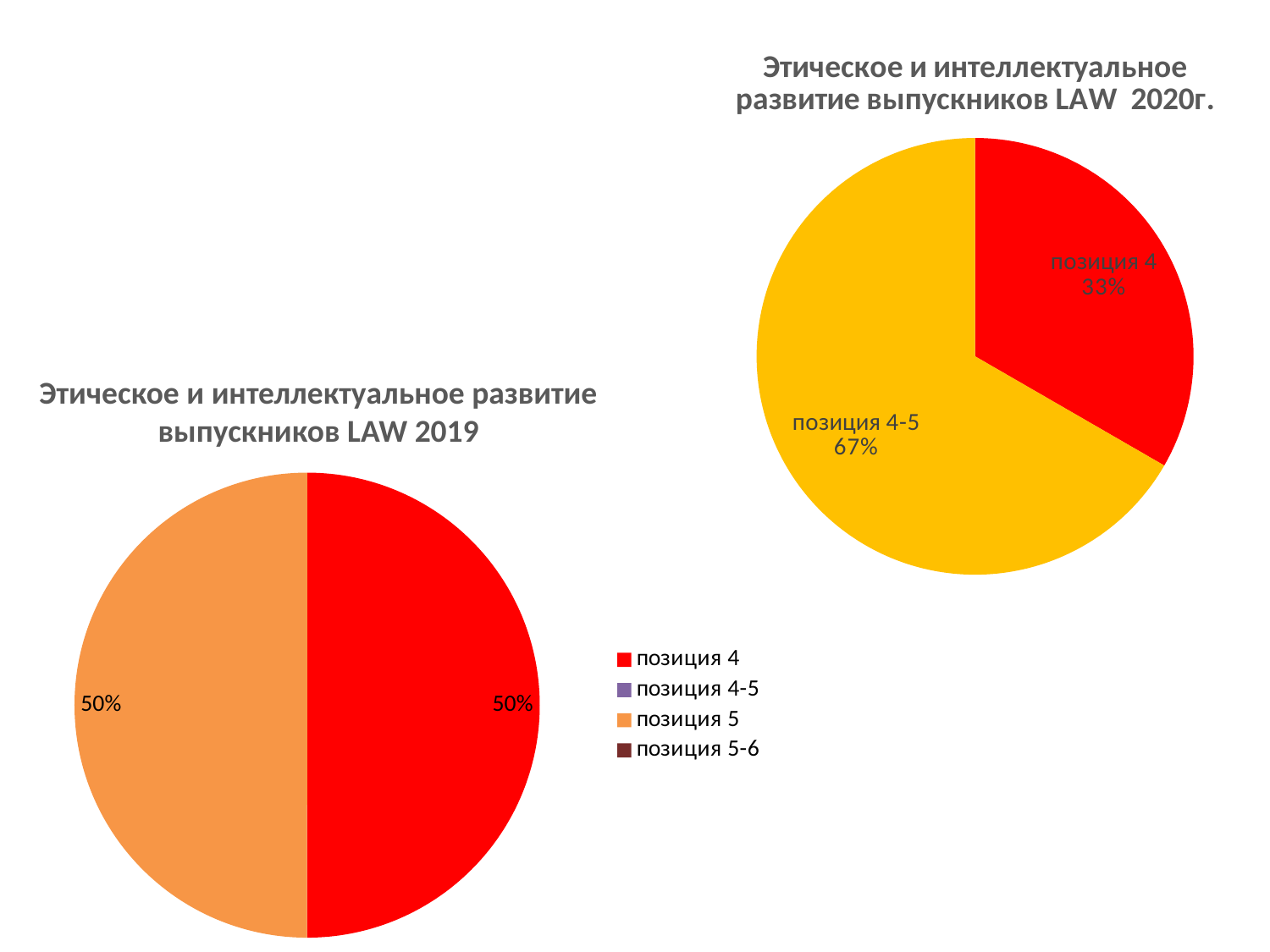
In the chart titled "Этическое и интеллектуальное развитие выпускников LAW 2020г.", how many slices does the pie have? 2 What kind of chart is the chart titled "Этическое и интеллектуальное развитие выпускников LAW 2019"? pie chart In the chart titled "Этическое и интеллектуальное развитие выпускников LAW 2020г.", what share does "позиция 4" have? 33% In the chart titled "Этическое и интеллектуальное развитие выпускников LAW 2019", how many slices does the pie have? 2 In the chart titled "Этическое и интеллектуальное развитие выпускников LAW 2020г.", which is larger: "позиция 4" or "позиция 4-5"? позиция 4-5 In the chart titled "Этическое и интеллектуальное развитие выпускников LAW 2019", what share does the red slice ("позиция 4") have? 50% In the chart titled "Этическое и интеллектуальное развитие выпускников LAW 2020г.", which slice is the largest? позиция 4-5 In the chart titled "Этическое и интеллектуальное развитие выпускников LAW 2020г.", what share does "позиция 4-5" have? 67% In the chart titled "Этическое и интеллектуальное развитие выпускников LAW 2020г.", which slice is the smallest? позиция 4 In the chart titled "Этическое и интеллектуальное развитие выпускников LAW 2020г.", what is the difference in percentage points between "позиция 4-5" and "позиция 4"? 34 How many entries does the legend on the slide list? 4